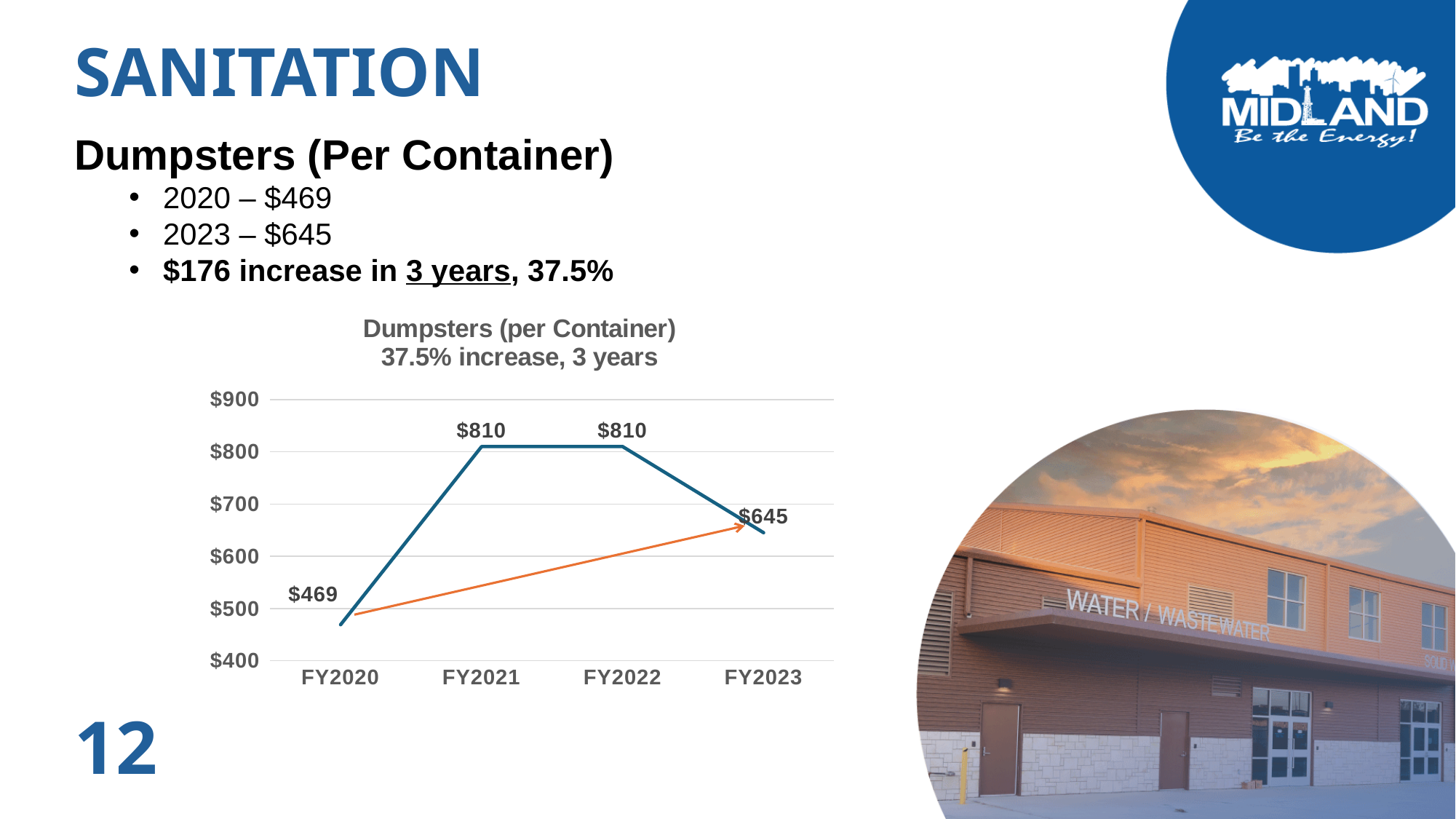
Which is larger in the Dumpsters (per Container) chart, the FY2021 value or the FY2023 value? FY2021 What kind of chart is the Dumpsters (per Container) chart? line chart Is the value for FY2020 in the Dumpsters (per Container) chart greater or less than $500? less What is the value for FY2021 in the Dumpsters (per Container) chart? $810 Does the value rise or fall from FY2022 to FY2023 in the Dumpsters (per Container) chart? fall What is the value for FY2023 in the Dumpsters (per Container) chart? $645 What is the value for FY2020 in the Dumpsters (per Container) chart? $469 What is the difference between the FY2023 and FY2020 values in the Dumpsters (per Container) chart? $176 Which fiscal year has the lowest value in the Dumpsters (per Container) chart? FY2020 What percentage increase over 3 years does the chart title state? 37.5% What is the difference between the FY2022 and FY2023 values in the Dumpsters (per Container) chart? $165 How many fiscal years are plotted in the Dumpsters (per Container) chart? 4